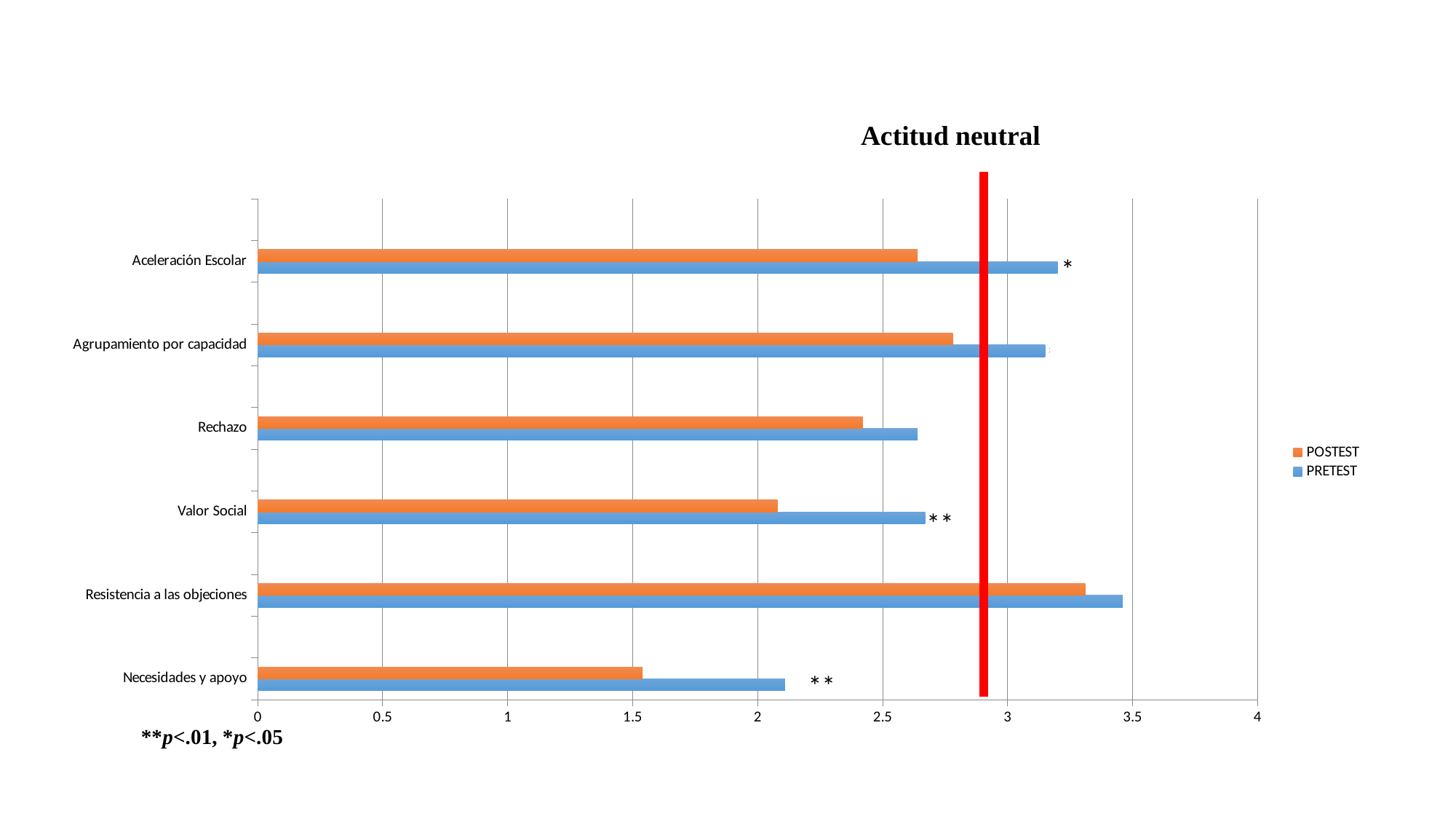
What label is given to the red vertical line on the chart? Actitud neutral What kind of chart is shown on the slide? Bar chart Is the POSTEST value for Necesidades y apoyo greater or less than 2? less Which category has the lowest POSTEST value? Necesidades y apoyo Is the POSTEST value for Resistencia a las objeciones greater or less than 3? greater Which category has the lowest PRETEST value? Necesidades y apoyo For Valor Social, which is larger, the PRETEST value or the POSTEST value? PRETEST How many series does the legend list? 2 How many categories are shown on the vertical axis of the chart? 6 Which category has the highest PRETEST value? Resistencia a las objeciones Is the PRETEST value for Aceleración Escolar greater or less than 3? greater Which series is shown in orange according to the legend? POSTEST